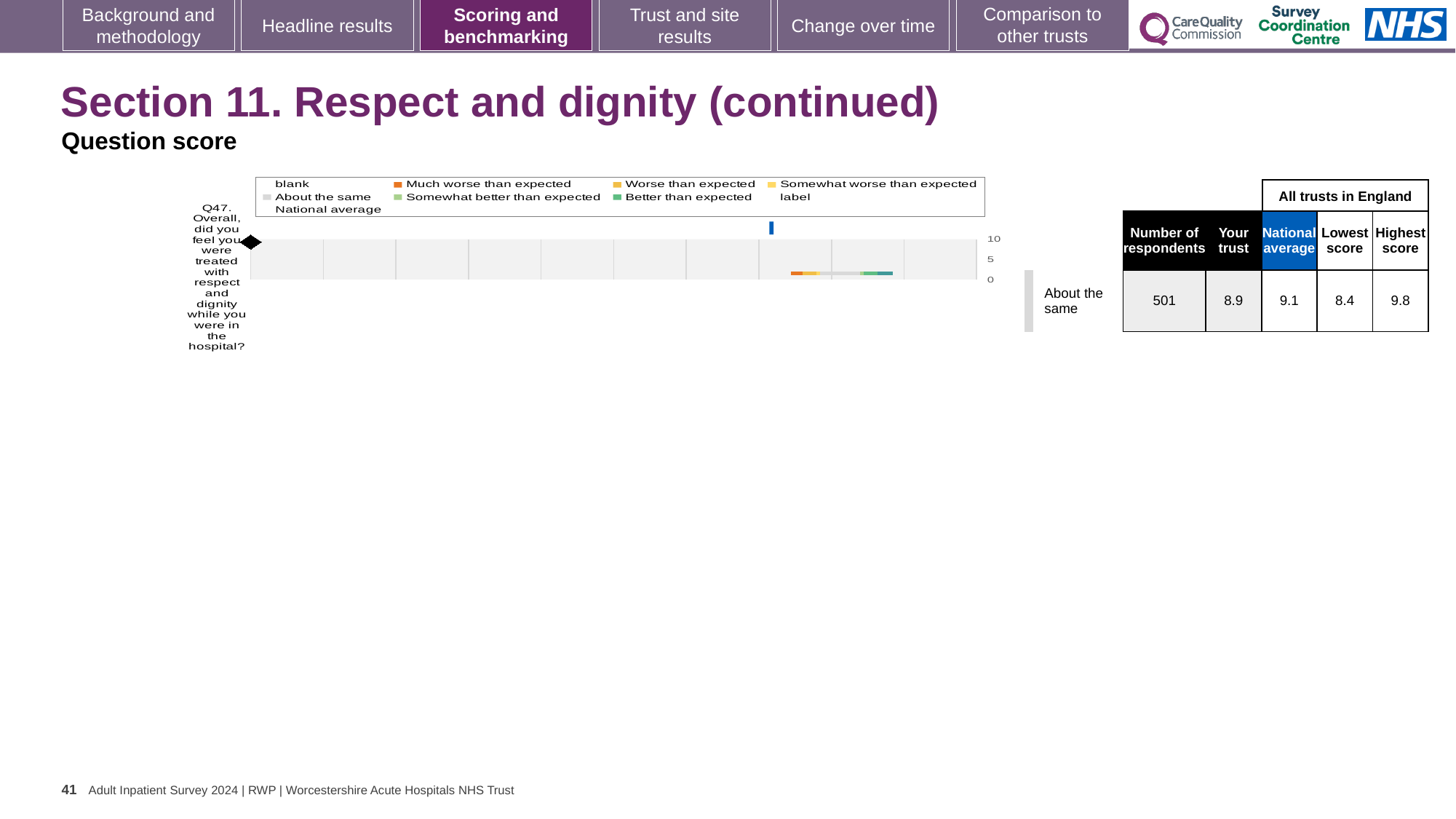
What is the highest score among all trusts in England for Q47? 9.8 How many questions are plotted on the chart? 1 How many entries does the chart legend list? 9 What is the national average score for Q47? 9.1 What is the difference between the highest score and the lowest score for Q47? 1.4 Which benchmarking category is Q47 placed in? About the same What is the highest value shown on the chart's score axis? 10 What kind of chart is used to show the Q47 question score? bar chart How many respondents answered Q47? 501 Which is larger for Q47, the 'Your trust' score or the national average? National average What is the 'Your trust' score for Q47? 8.9 What is the lowest score among all trusts in England for Q47? 8.4